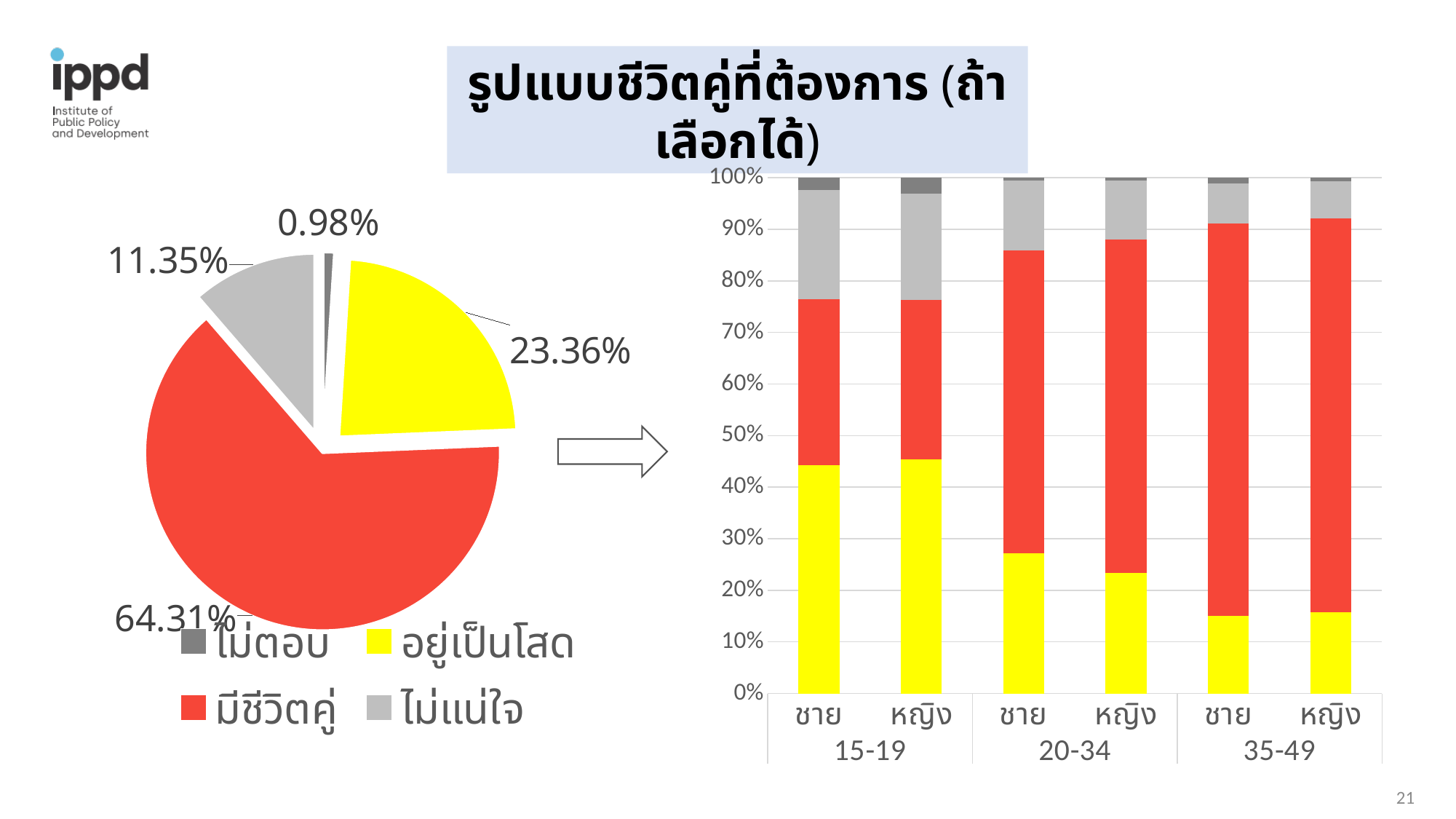
In the pie chart on the left, which category has the largest slice? มีชีวิตคู่ In the stacked bar chart on the right, how many bars are plotted? 6 In the pie chart on the left, what share does the มีชีวิตคู่ slice have? 64.31% In the pie chart on the left, what share does the อยู่เป็นโสด slice have? 23.36% In the pie chart on the left, which category has the smallest slice? ไม่ตอบ In the pie chart on the left, how many categories does the legend list? 4 In the pie chart on the left, what is the difference between the มีชีวิตคู่ share and the อยู่เป็นโสด share? 40.95% What kind of chart is shown on the right of the slide? Stacked bar chart What kind of chart is shown on the left of the slide? Pie chart In the pie chart on the left, what share does the ไม่แน่ใจ slice have? 11.35% In the stacked bar chart on the right, is the yellow (อยู่เป็นโสด) segment for หญิง in the 35-49 group greater or less than 20%? less In the stacked bar chart on the right, is the yellow (อยู่เป็นโสด) segment for ชาย in the 15-19 group greater or less than 40%? greater